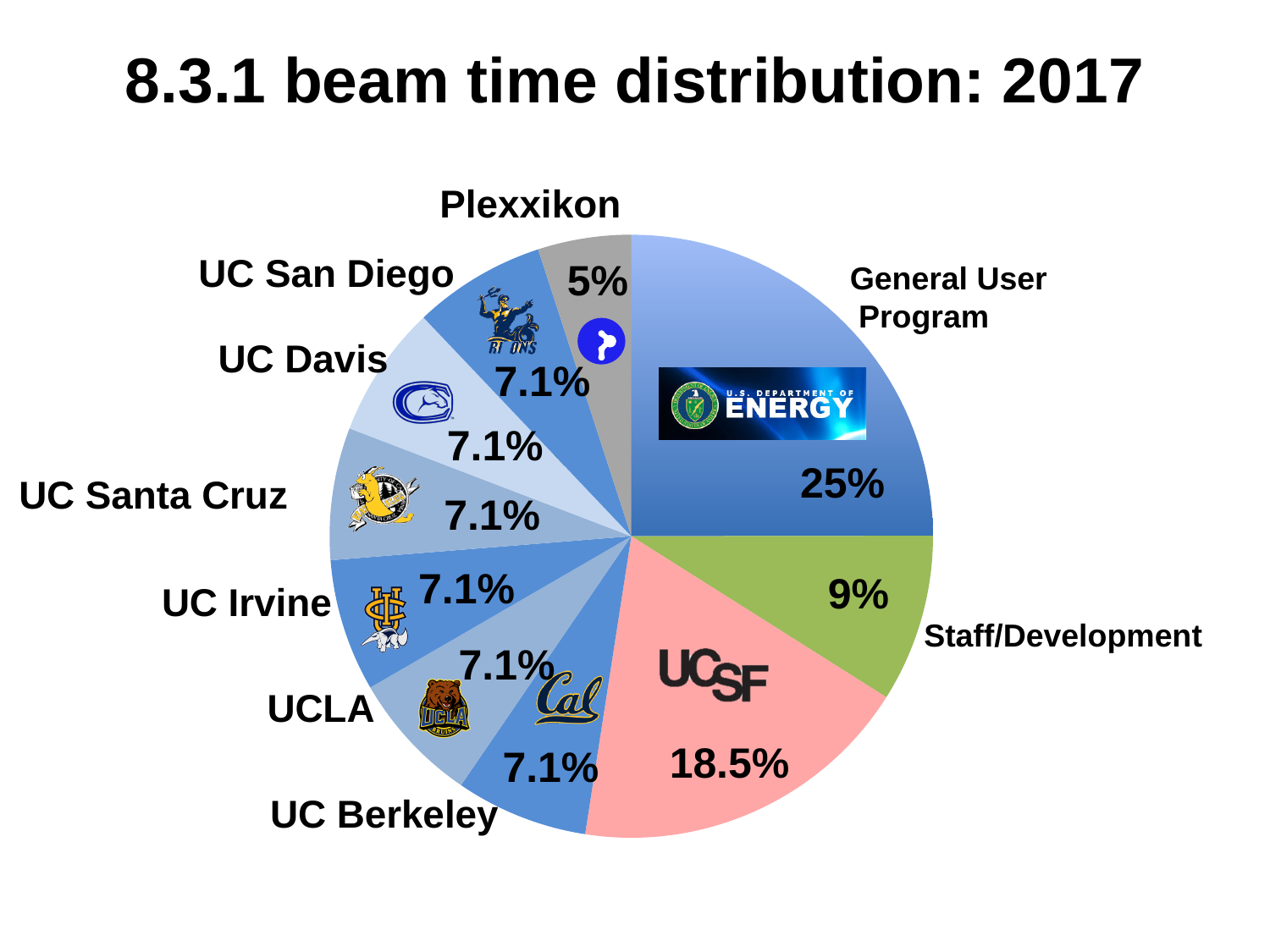
What share of beam time went to UCSF? 18.5% Which category has the smallest share of beam time? Plexxikon What is the title of the chart? 8.3.1 beam time distribution: 2017 What share of beam time went to the General User Program? 25% What type of chart is shown on the slide? pie chart What is the difference between the General User Program share and the UCSF share? 6.5% What share of beam time went to UC Berkeley? 7.1% What share of beam time went to Staff/Development? 9% What share of beam time went to Plexxikon? 5% Which category has the largest share of beam time? General User Program How many slices does the pie chart have? 10 Which has a larger share of beam time, Staff/Development or UC Davis? Staff/Development